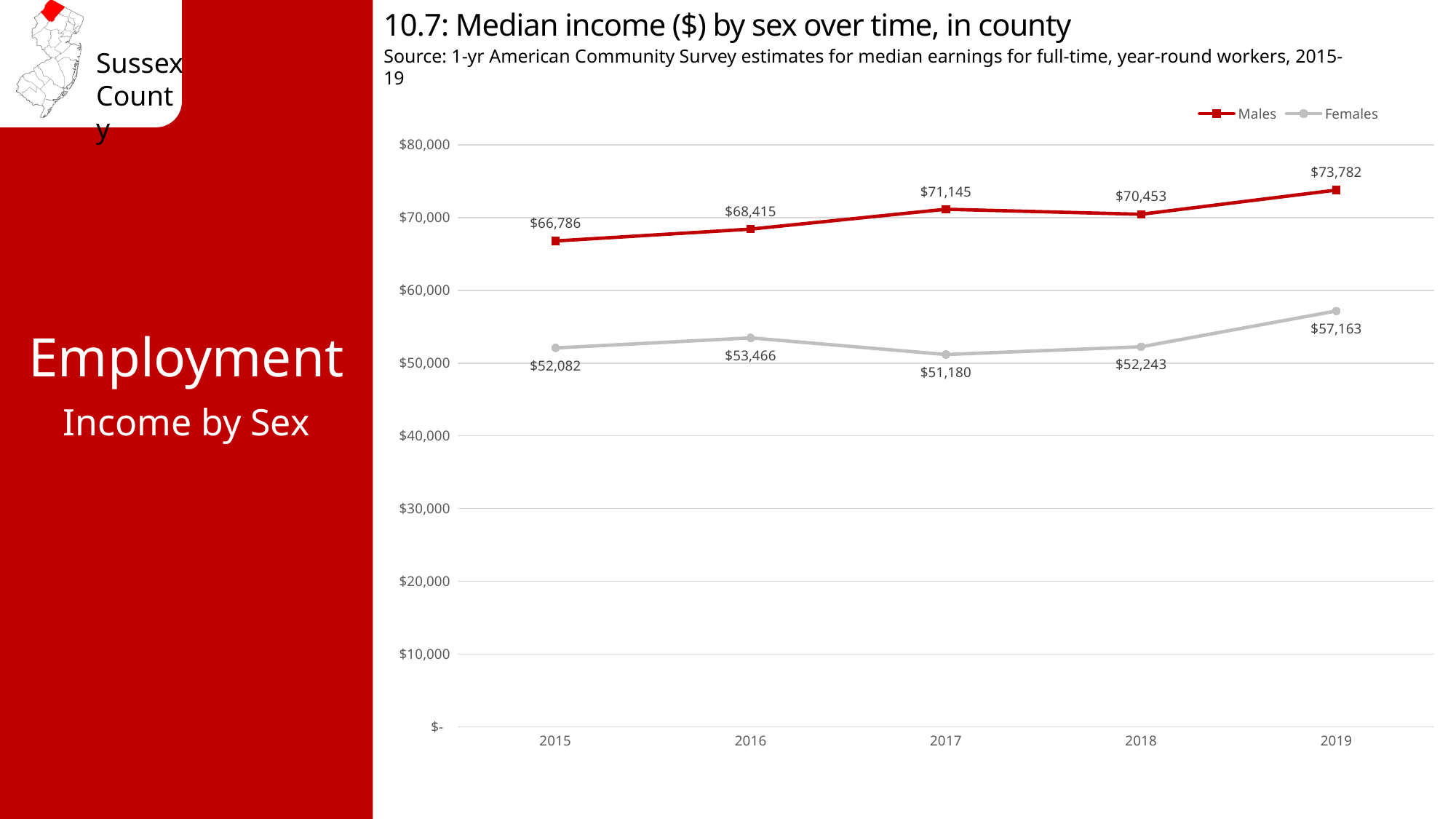
How many years are shown on the x axis? 5 In which year was the median income for Males highest? 2019 What was the median income for Males in 2017? $71,145 Did the median income for Males rise or fall from 2015 to 2016? rise Which was larger in 2018: the median income for Males or for Females? Males What is the difference between the Males and Females median income in 2019? $16,619 What kind of chart is shown on the slide? line chart In which year was the median income for Females lowest? 2017 How many series does the legend list? 2 What was the median income for Females in 2019? $57,163 Is the median income for Females in 2016 greater or less than $60,000? less What was the median income for Females in 2015? $52,082